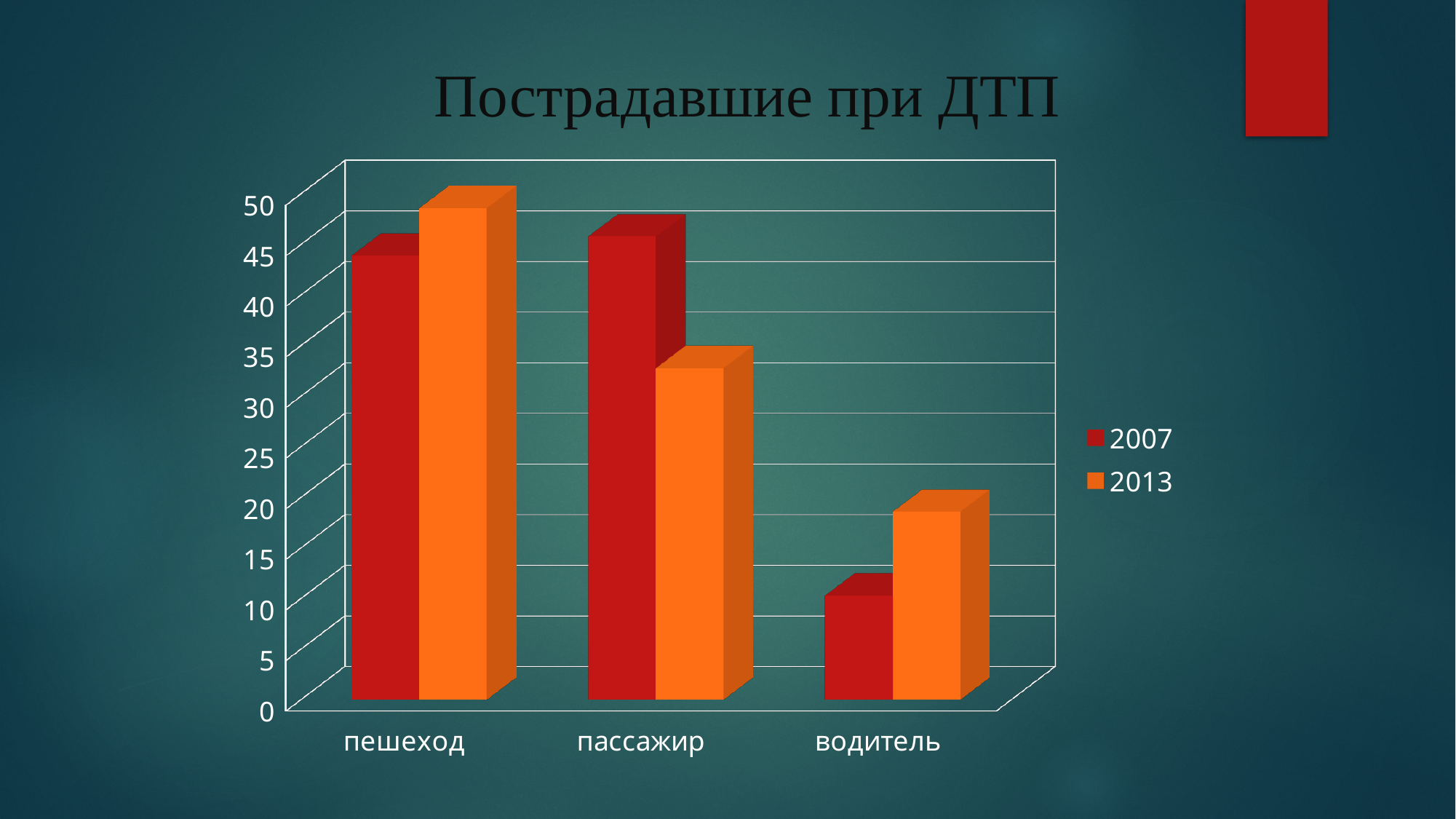
Which category has the lowest value in the 2013 series? водитель What kind of chart is shown on the slide? bar chart How many series does the legend list? 2 Is the 2013 value for пешеход greater or less than 40? greater Is the 2007 value for водитель greater or less than 15? less How many categories are shown on the x axis? 3 Is the 2013 value for водитель greater or less than 25? less Which years are listed in the legend? 2007 and 2013 What is the title of the chart? Пострадавшие при ДТП For пассажир, which year has the larger value, 2007 or 2013? 2007